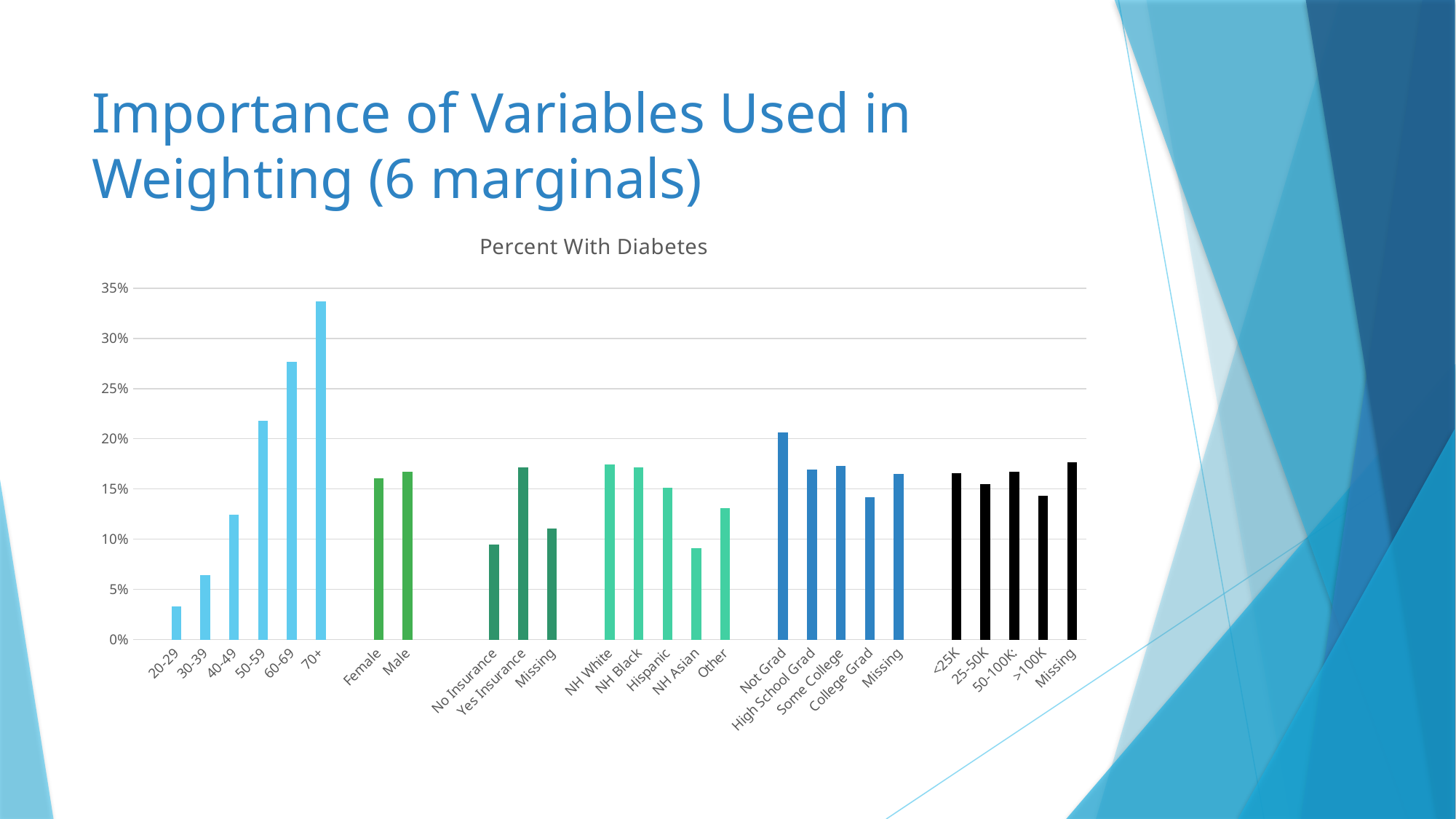
Which category has the lowest percent with diabetes? 20-29 Which category has the highest percent with diabetes? 70+ Is the value for Not Grad greater or less than 20%? greater How many bars are plotted in the chart? 26 Which is larger, the value for No Insurance or the value for Yes Insurance? Yes Insurance Is the value for 20-29 greater or less than 5%? less Which is larger, the value for NH White or the value for NH Asian? NH White What is the title of the chart? Percent With Diabetes Is the value for No Insurance greater or less than 10%? less What kind of chart is shown on the slide? bar chart Do the values rise or fall across the age groups from 20-29 to 70+? rise